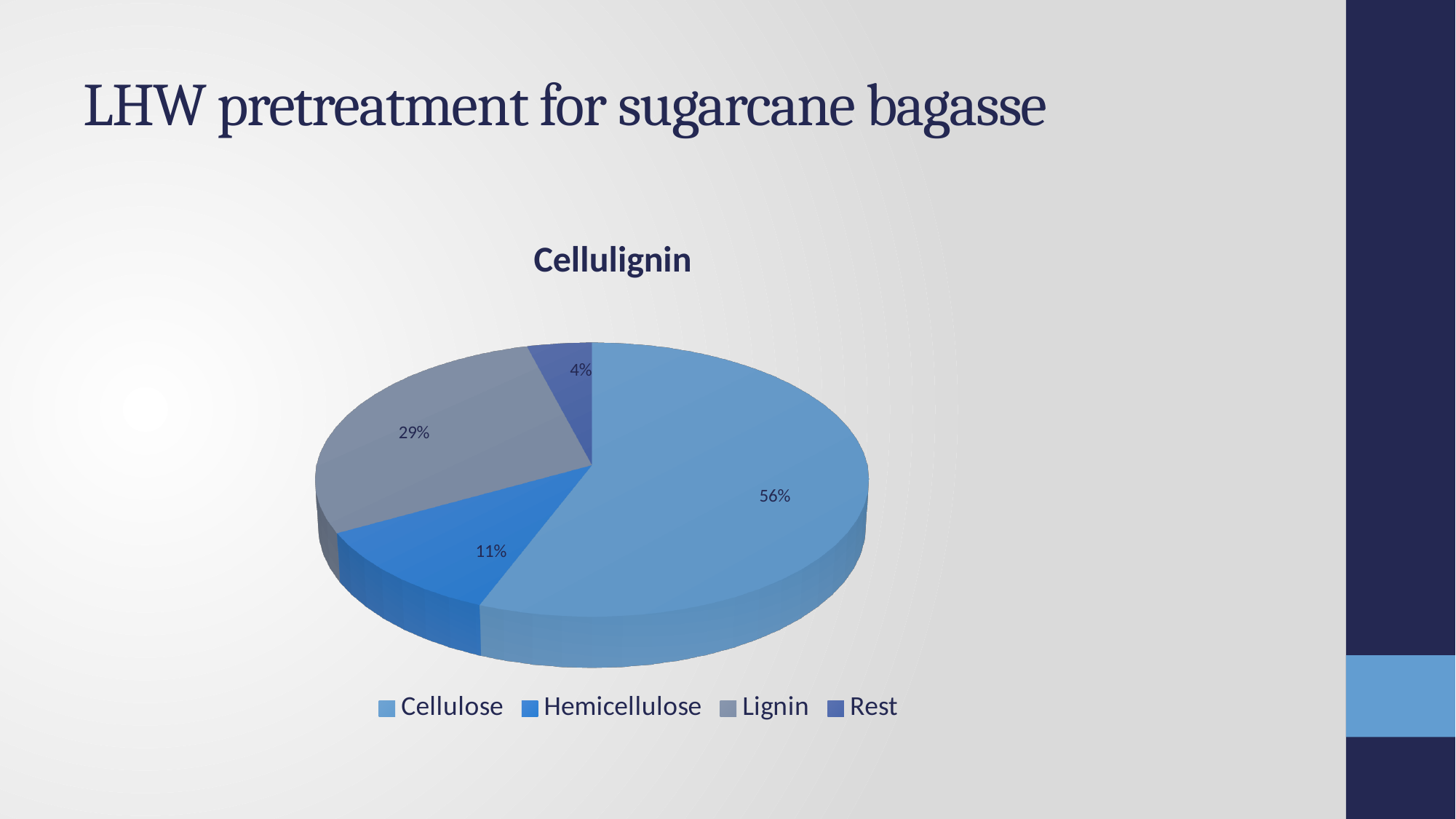
What percentage of the pie does Lignin represent? 29% What type of chart is shown on the slide? pie chart What is the difference in percentage points between Cellulose and Lignin? 27 Which category has the largest share of the pie? Cellulose Which is larger, the share for Lignin or the share for Hemicellulose? Lignin How many categories are shown in the pie chart? 4 What is the title of the chart? Cellulignin What percentage of the pie does Cellulose represent? 56% What percentage of the pie does Rest represent? 4% What percentage of the pie does Hemicellulose represent? 11% Which category has the smallest share of the pie? Rest How many entries does the legend list? 4